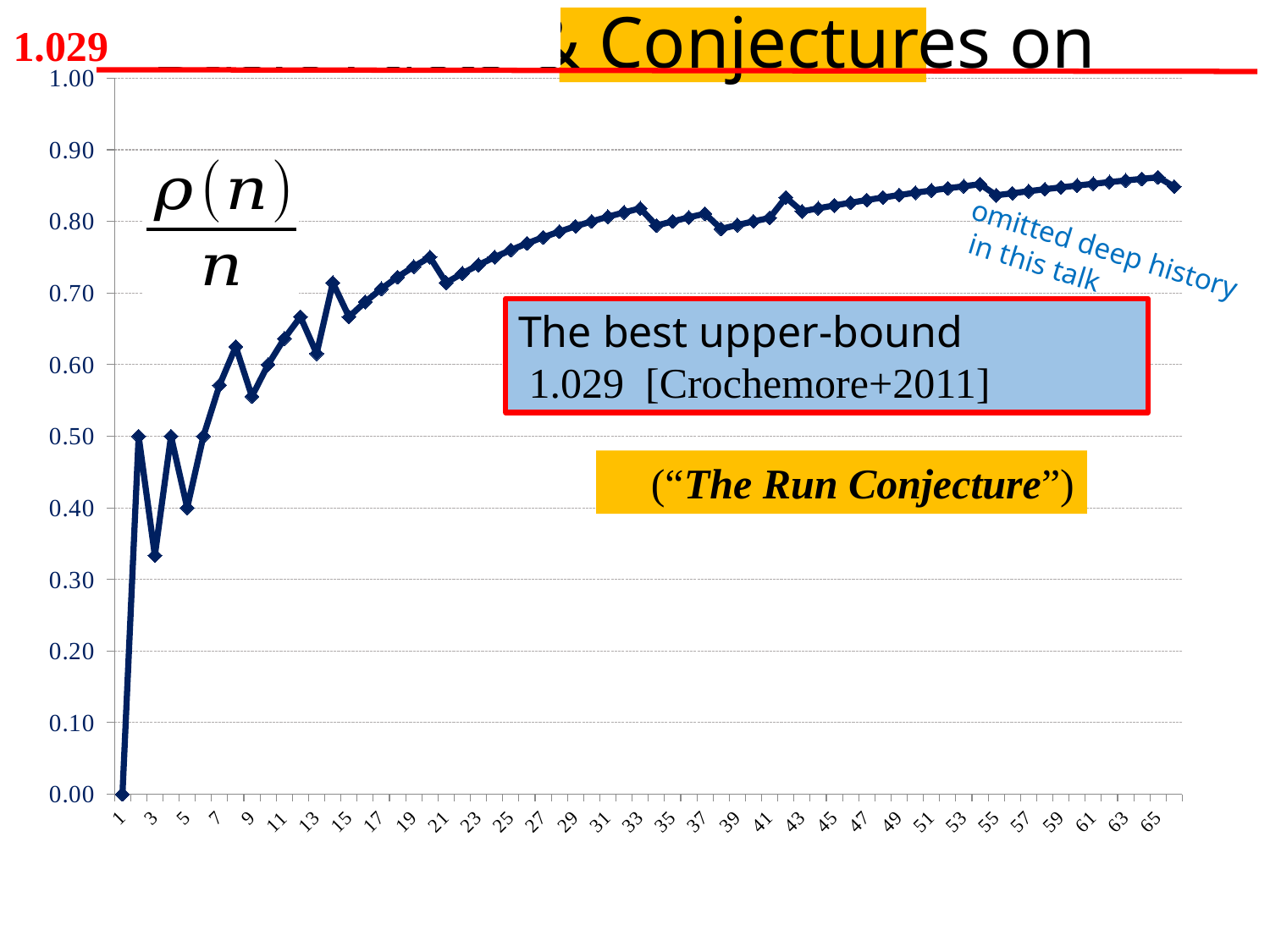
Is the value for n = 9 greater or less than 0.50? greater Is the value for n = 65 greater or less than 0.80? greater What is the value of ρ(n)/n at n = 1? 0.00 At which value of n is ρ(n)/n lowest? 1 What is the value of ρ(n)/n at n = 5? 0.40 Which is larger, the value at n = 2 or the value at n = 3? n = 2 Overall, do the values rise or fall as n increases along the x axis? rise What is the highest tick value shown on the y axis? 1.00 Is the value for n = 3 greater or less than 0.40? less What kind of chart is shown on the slide? line chart What is the value of ρ(n)/n at n = 2? 0.50